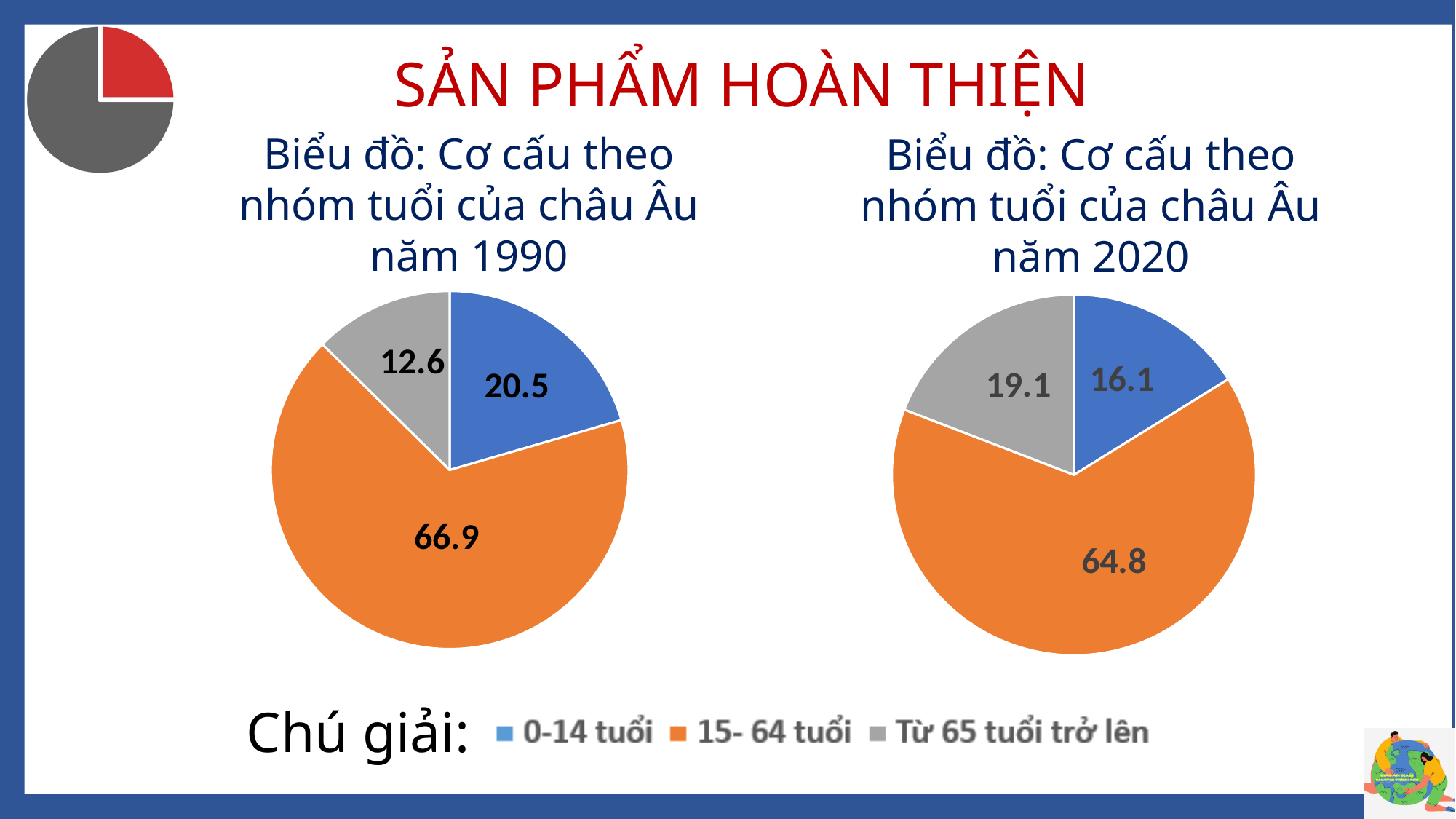
In the 1990 pie chart (left), what is the value for the 15- 64 tuổi slice? 66.9 In the 1990 pie chart (left), what is the difference between the 0-14 tuổi slice and the Từ 65 tuổi trở lên slice? 7.9 In the 2020 pie chart (right), which age group has the smallest slice? 0-14 tuổi What is the difference between the 0-14 tuổi value in the 1990 chart and the 0-14 tuổi value in the 2020 chart? 4.4 In the 1990 pie chart (left), what is the value for the 0-14 tuổi slice? 20.5 Which is larger: the Từ 65 tuổi trở lên value in the 1990 chart or in the 2020 chart? 2020 How many slices does the 2020 pie chart (right) have? 3 In the 2020 pie chart (right), what is the value for the Từ 65 tuổi trở lên slice? 19.1 In the 1990 pie chart (left), which age group has the smallest slice? Từ 65 tuổi trở lên What type of chart is used for the 1990 data on the left? Pie chart In the 2020 pie chart (right), which age group has the largest slice? 15- 64 tuổi Which colour represents the 15- 64 tuổi group in the legend? Orange